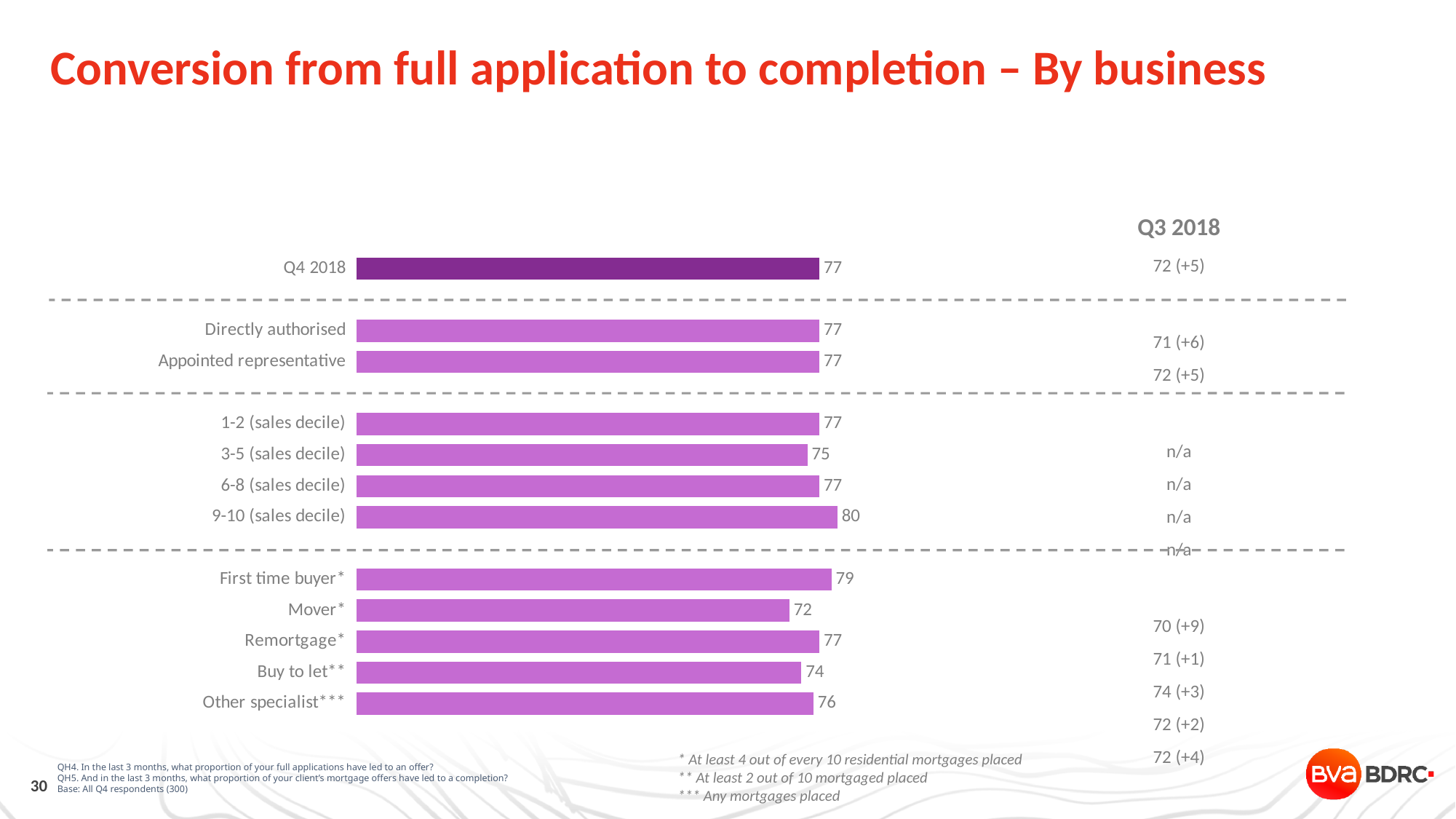
What is the difference between the values for First time buyer* and Mover*? 7 What is the difference between the values for 9-10 (sales decile) and 3-5 (sales decile)? 5 What is the value for 9-10 (sales decile)? 80 What type of chart is shown on the slide? Bar chart Which category has the lowest value in the chart? Mover* How many bars are plotted in the chart? 12 What is the value for Buy to let**? 74 Which category has the highest value in the chart? 9-10 (sales decile) What is the value for Q4 2018 in the bar chart? 77 Which is larger, the value for First time buyer* or the value for Remortgage*? First time buyer* What is the value for Other specialist***? 76 What is the value for Mover*? 72